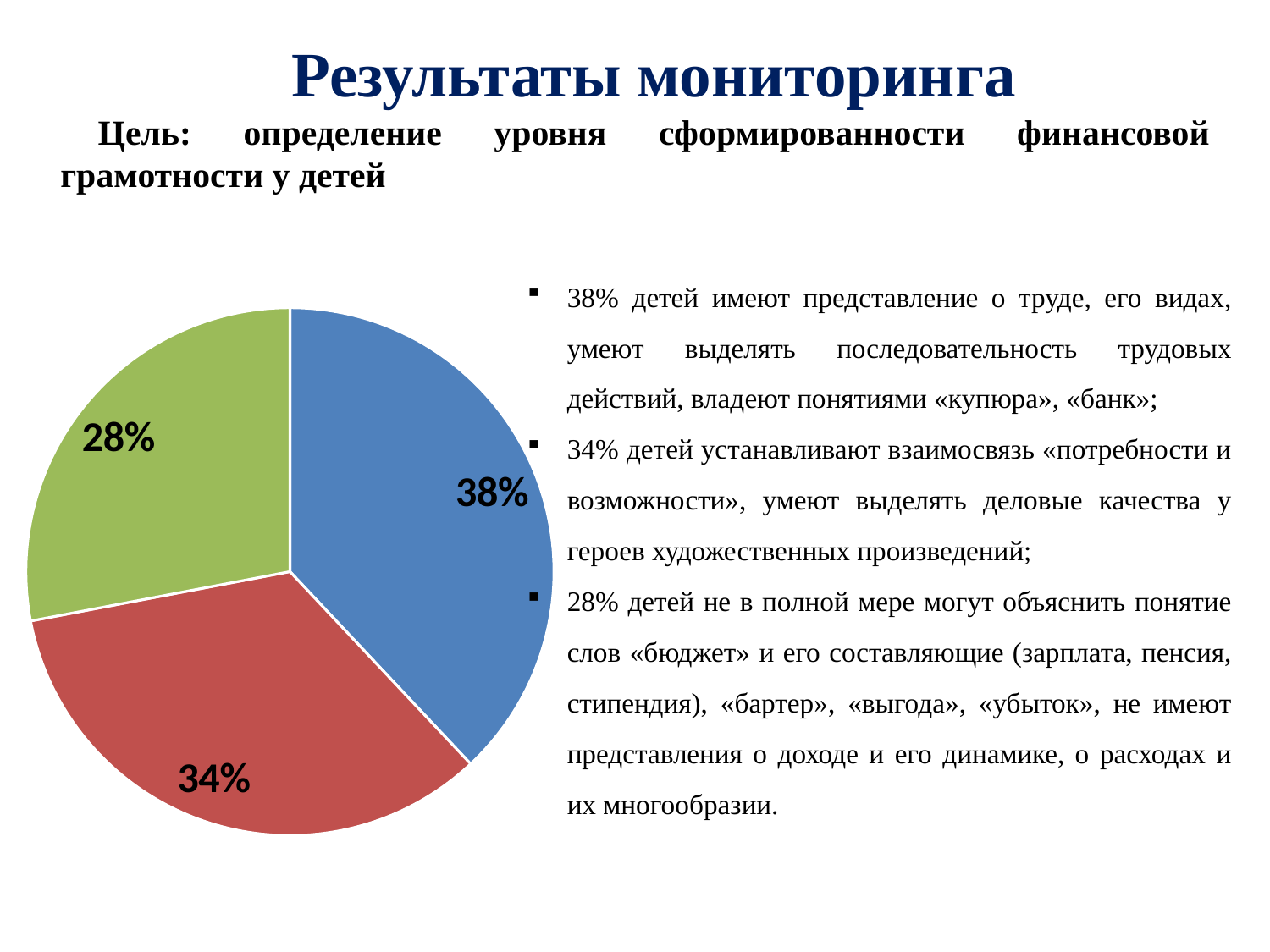
What value is shown on the green slice of the pie chart? 28% What value is shown on the red slice of the pie chart? 34% Which is larger in the pie chart, the red slice or the green slice? the red slice Which slice of the pie chart is the smallest? the green slice (28%) What value is shown on the blue slice of the pie chart? 38% What do the three slices of the pie chart add up to? 100% What is the difference between the blue slice and the red slice of the pie chart? 4% What is the difference between the largest and smallest slices of the pie chart? 10% How many slices does the pie chart have? 3 Does the pie chart have a legend? No Which slice of the pie chart is the largest? the blue slice (38%) What kind of chart is shown on the slide? pie chart